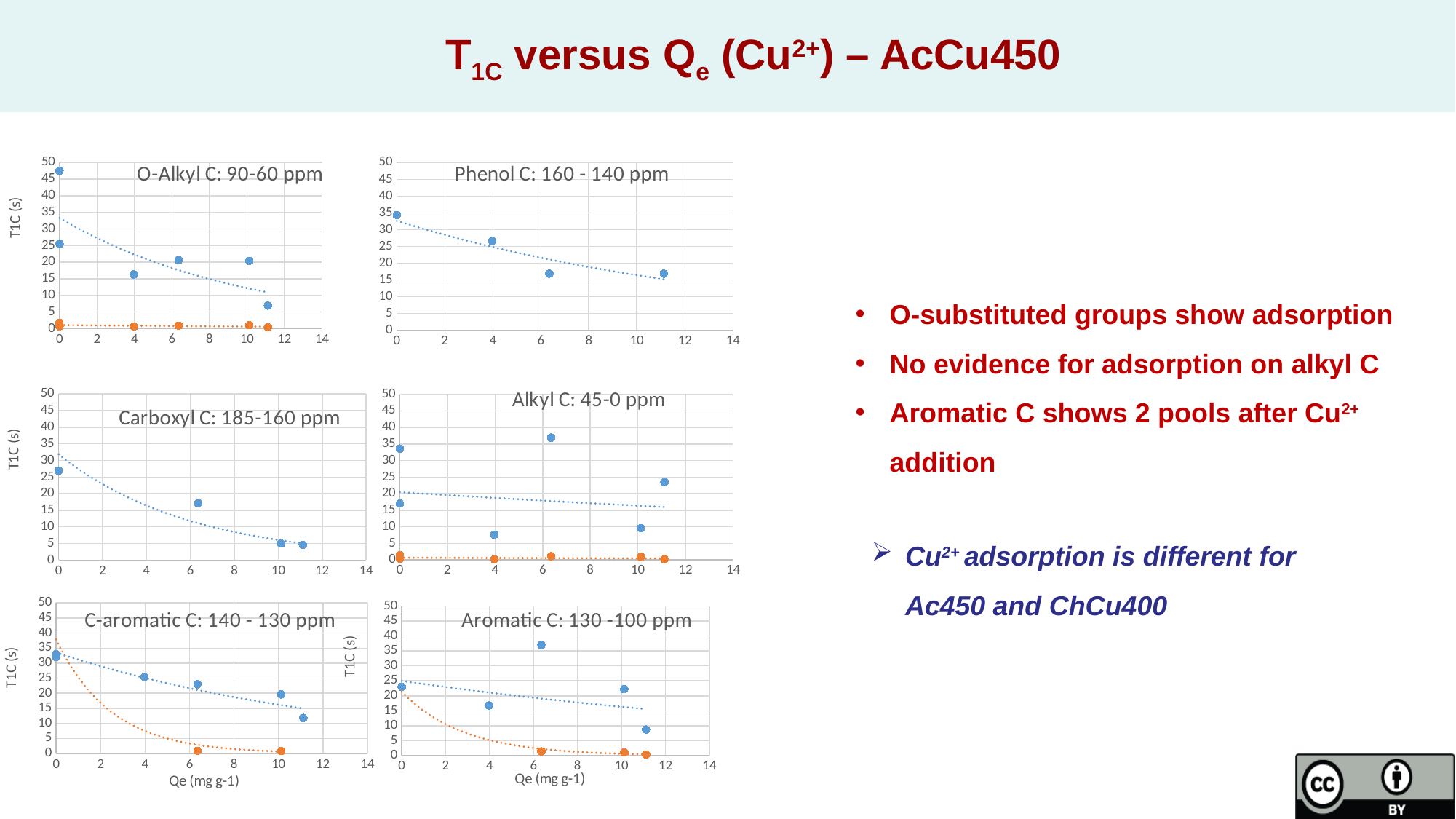
In the 'Carboxyl C: 185-160 ppm' chart, is the T1C value of the point near Qe = 11 greater or less than 10? less What is the x-axis label shown under the bottom charts? Qe (mg g-1) In the 'Phenol C: 160 - 140 ppm' chart, is the T1C value at Qe = 0 greater or less than 30? greater In the 'Phenol C: 160 - 140 ppm' chart, do the T1C values rise or fall as Qe increases? fall In the 'Phenol C: 160 - 140 ppm' chart, how many data points are plotted? 4 In the 'C-aromatic C: 140 - 130 ppm' chart, is the orange point near Qe = 6 greater or less than 5? less How many charts are shown on the slide? 6 In the 'Carboxyl C: 185-160 ppm' chart, do the T1C values rise or fall as Qe increases? fall In the 'O-Alkyl C: 90-60 ppm' chart, is the blue point at Qe = 0 higher or lower than the blue point at Qe = 4? higher What kind of chart is the 'Phenol C: 160 - 140 ppm' chart? scatter chart